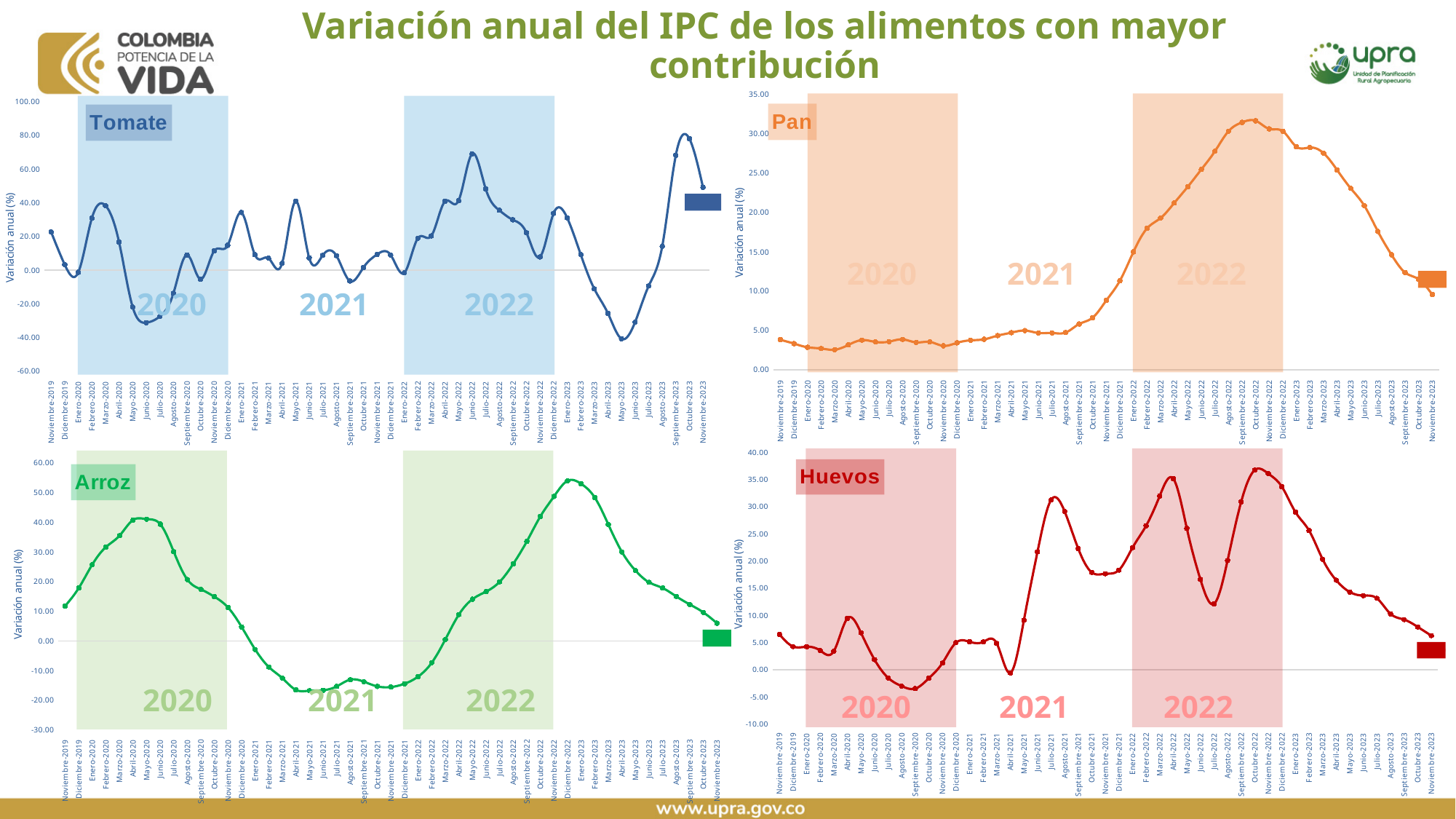
In the Tomate chart, which month has the lowest value? Mayo-2023 In the Pan chart, do the values rise or fall from Enero-2023 to Noviembre-2023? fall In the Pan chart, is the value for Octubre-2022 greater or less than 30.00? greater In the Arroz chart, do the values rise or fall from Enero-2023 to Noviembre-2023? fall In the Pan chart, is the value for Noviembre-2019 greater or less than 5.00? less In the Arroz chart, is the value for Enero-2023 greater or less than 50.00? greater In the Tomate chart, which month has the highest value? Octubre-2023 What kind of chart is the Tomate chart? line chart In the Pan chart, which is larger, the value for Octubre-2022 or the value for Noviembre-2023? Octubre-2022 What is the label on the vertical axis of the Huevos chart? Variación anual (%)